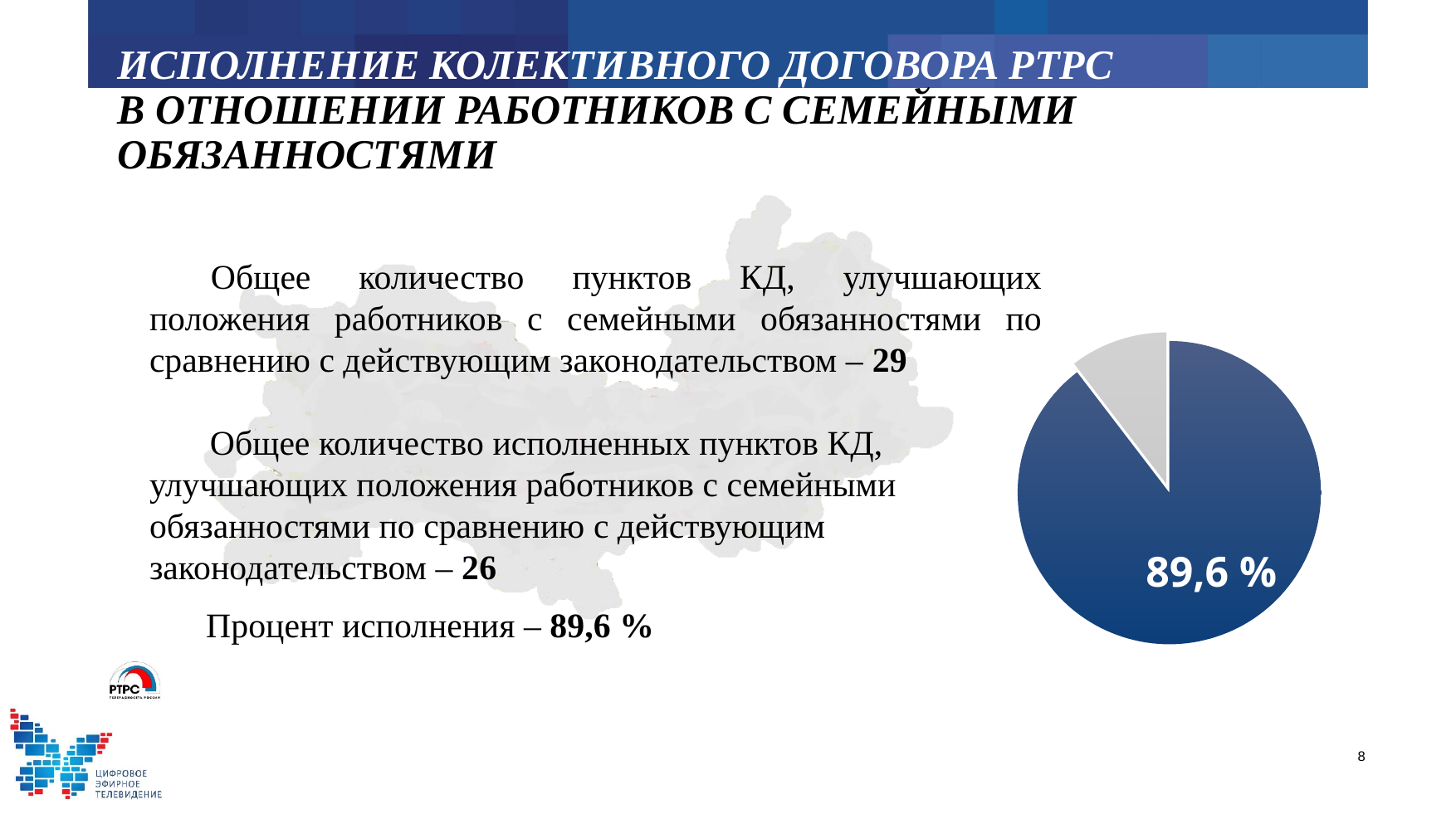
What value is printed on the large blue slice of the pie chart? 89,6 % What kind of chart is shown on the slide? pie chart Which slice of the pie chart is the smallest? the grey slice What share of the pie does the blue slice represent? 89,6 % How many slices does the pie chart have? 2 What colour is the largest slice of the pie chart? dark blue Which slice of the pie chart is larger, the blue one or the grey one? the blue one Does the pie chart have a legend? no